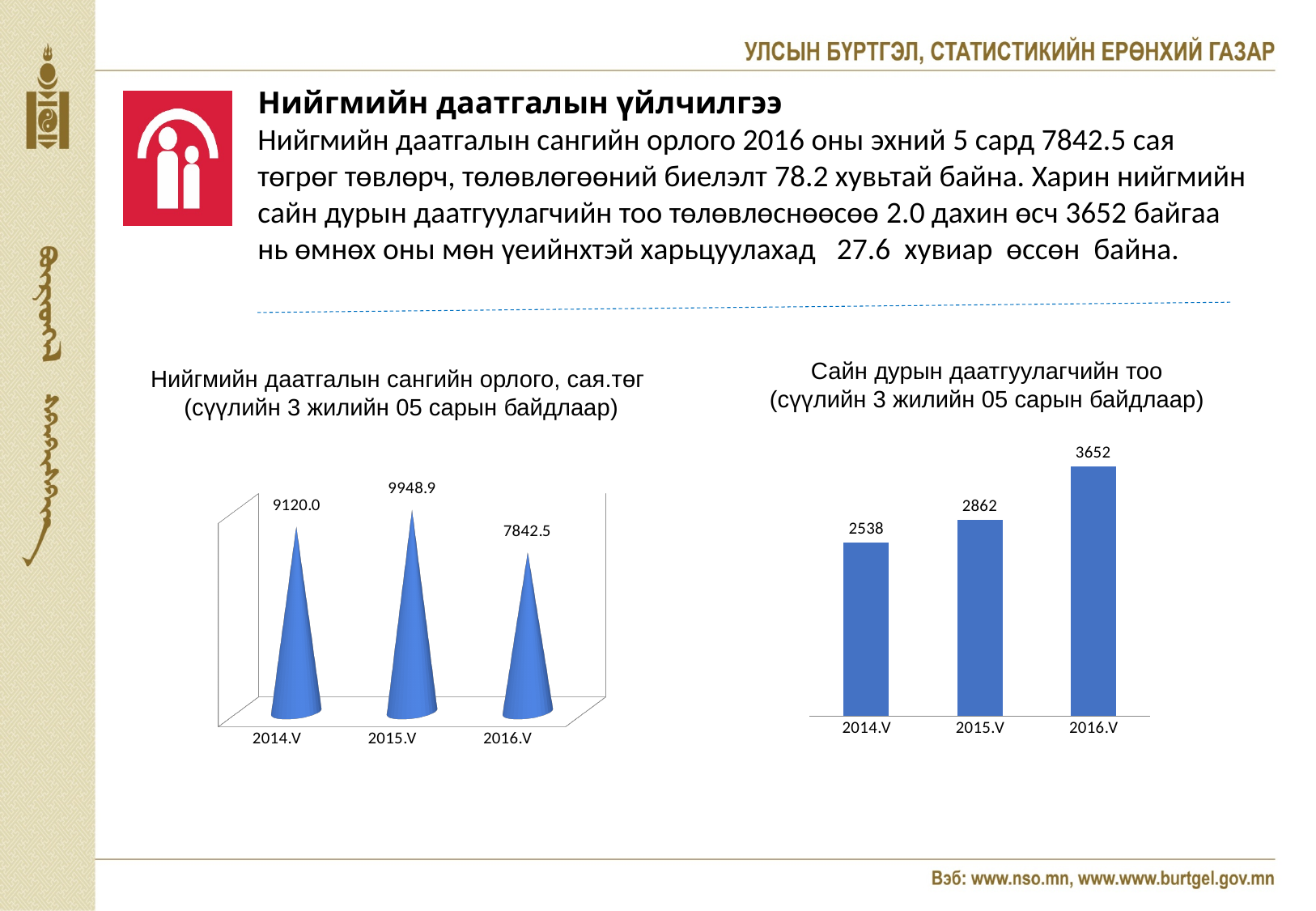
In the left chart (Нийгмийн даатгалын сангийн орлого), what is the value for 2015.V? 9948.9 What kind of chart is the right chart (Сайн дурын даатгуулагчийн тоо)? bar chart In the left chart (Нийгмийн даатгалын сангийн орлого), what is the value for 2016.V? 7842.5 In the left chart (Нийгмийн даатгалын сангийн орлого), which year has the highest value? 2015.V In the right chart (Сайн дурын даатгуулагчийн тоо), what is the difference between the 2016.V and 2015.V values? 790 In the right chart (Сайн дурын даатгуулагчийн тоо), what is the value for 2016.V? 3652 How many categories are shown in the right chart (Сайн дурын даатгуулагчийн тоо)? 3 In the right chart (Сайн дурын даатгуулагчийн тоо), do the values rise or fall from 2014.V to 2016.V? rise In the right chart (Сайн дурын даатгуулагчийн тоо), which year has the highest value? 2016.V In the left chart (Нийгмийн даатгалын сангийн орлого), which year has the lowest value? 2016.V In the right chart (Сайн дурын даатгуулагчийн тоо), what is the value for 2014.V? 2538 In the left chart (Нийгмийн даатгалын сангийн орлого), what is the difference between the 2015.V and 2014.V values? 828.9